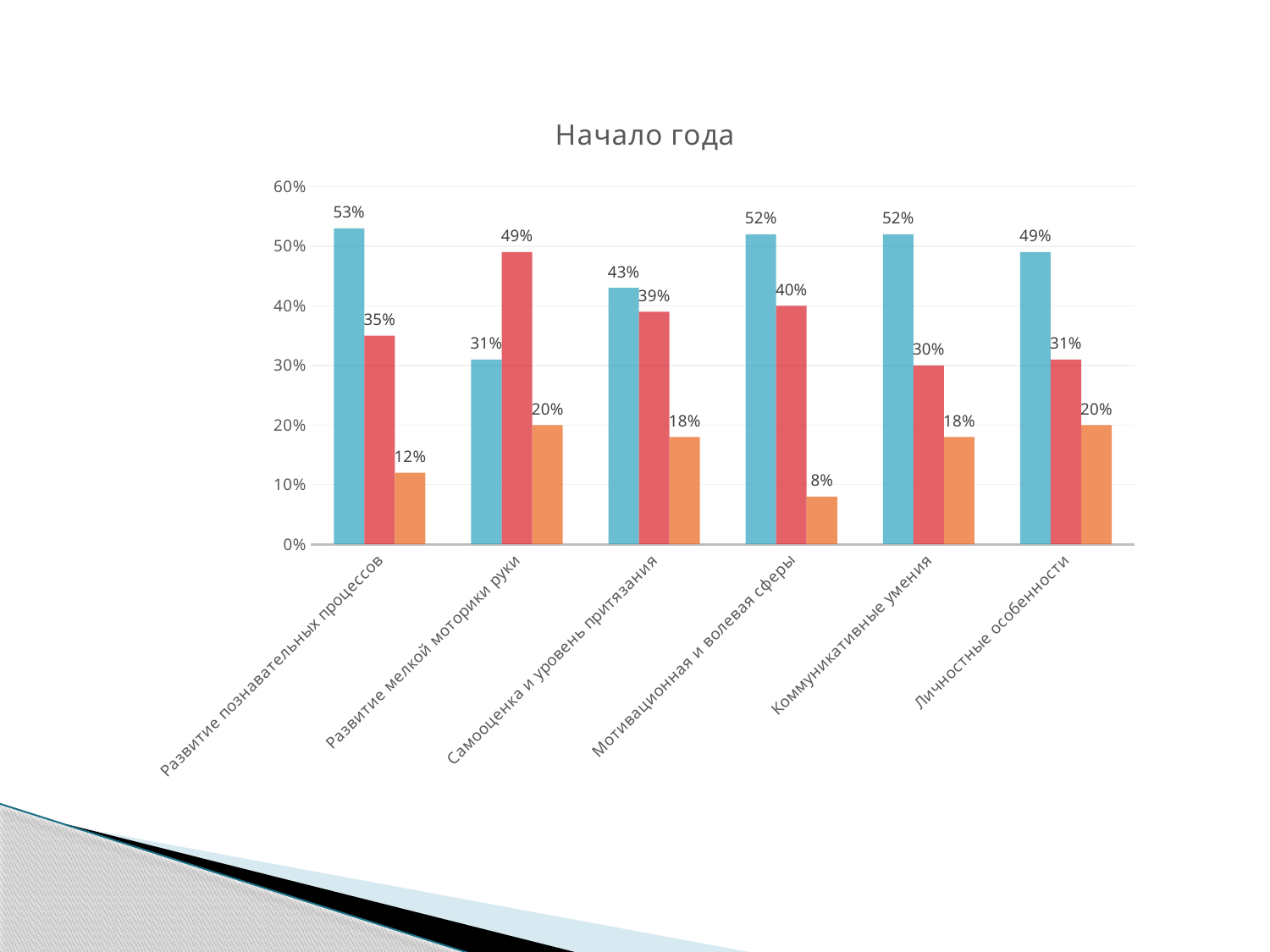
What is the value of the orange bar for Мотивационная и волевая сферы? 8% Which category has the highest blue bar? Развитие познавательных процессов What type of chart is shown on the slide? bar chart How many categories are shown on the x axis of the chart? 6 What is the difference between the red bar and the orange bar for Самооценка и уровень притязания? 21% What is the value of the blue bar for Развитие познавательных процессов? 53% What is the difference between the blue bar and the red bar for Коммуникативные умения? 22% What is the value of the red bar for Развитие мелкой моторики руки? 49% What is the value of the orange bar for Личностные особенности? 20% Which is larger for Развитие мелкой моторики руки: the blue bar or the red bar? the red bar Which category has the lowest orange bar? Мотивационная и волевая сферы What is the title of the chart? Начало года